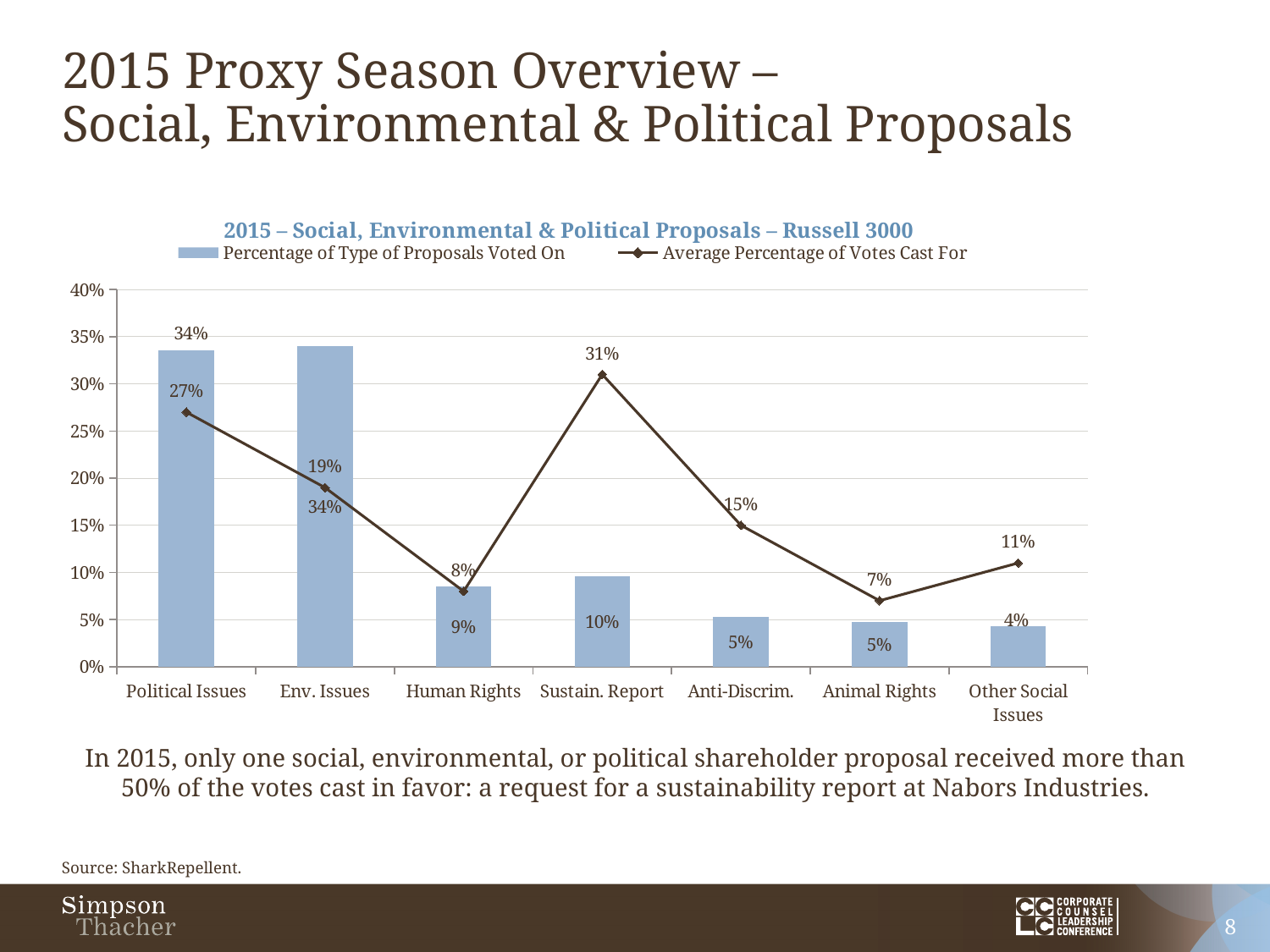
Which category had the lowest average percentage of votes cast for? Animal Rights Which is larger: the average percentage of votes cast for Anti-Discrim. or for Other Social Issues? Anti-Discrim. What was the average percentage of votes cast for Human Rights proposals? 8% What was the average percentage of votes cast for Sustain. Report proposals? 31% What percentage of proposals voted on were Other Social Issues? 4% How many series does the legend list? 2 How many proposal categories are shown on the x axis? 7 Which category had the lowest percentage of type of proposals voted on? Other Social Issues What is the difference between the average percentage of votes cast for Political Issues and for Env. Issues? 8% What is the title of the chart? 2015 – Social, Environmental & Political Proposals – Russell 3000 What percentage of proposals voted on were Political Issues? 34% Which category had the highest average percentage of votes cast for? Sustain. Report